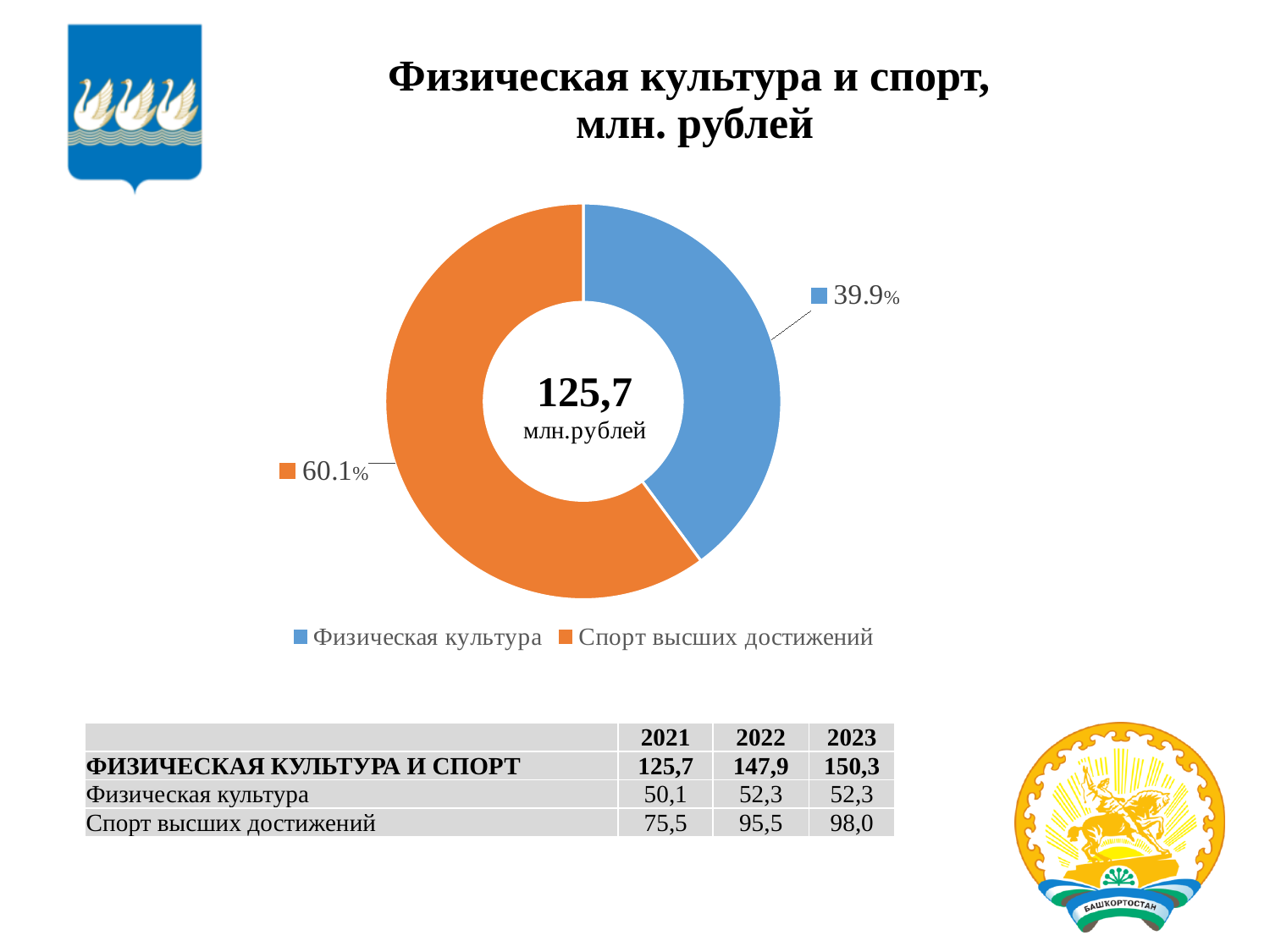
How many entries does the chart legend list? 2 Which category has the smallest slice in the chart? Физическая культура What is the title of the chart? Физическая культура и спорт, млн. рублей What share of the chart does Физическая культура account for? 39.9% What total value is shown in the centre of the doughnut chart? 125,7 млн.рублей By how many percentage points does the share of Спорт высших достижений exceed the share of Физическая культура? 20.2 percentage points How many slices does the chart have? 2 What kind of chart is shown on the slide? doughnut (pie) chart Which is larger: the share of Физическая культура or the share of Спорт высших достижений? Спорт высших достижений What share of the chart does Спорт высших достижений account for? 60.1% What colour represents Физическая культура in the chart? blue Which category has the largest slice in the chart? Спорт высших достижений